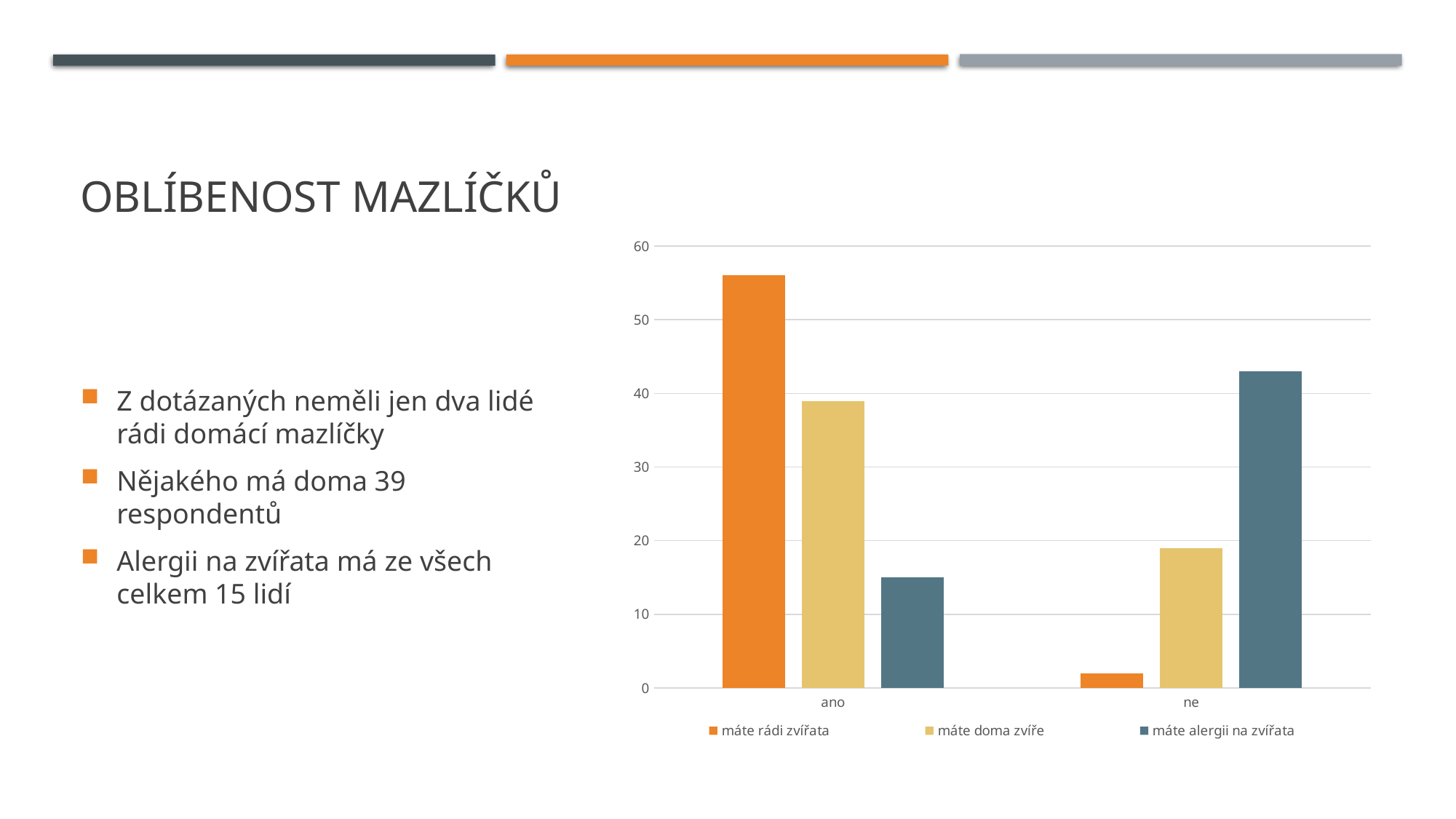
How many categories are shown on the x axis of the chart? 2 Is the value for "máte alergii na zvířata" in the "ne" category greater or less than 40? greater How many series does the chart legend list? 3 What is the title of the slide containing the chart? OBLÍBENOST MAZLÍČKŮ Is the value for "máte alergii na zvířata" in the "ano" category greater or less than 20? less Which series has the tallest bar in the "ne" category? máte alergii na zvířata Which series has the shortest bar in the "ne" category? máte rádi zvířata What kind of chart is shown on the slide? bar chart Which series has the tallest bar in the "ano" category? máte rádi zvířata Which is larger: "máte doma zvíře" for "ano" or "máte doma zvíře" for "ne"? ano Is the value for "máte rádi zvířata" in the "ano" category greater or less than 50? greater